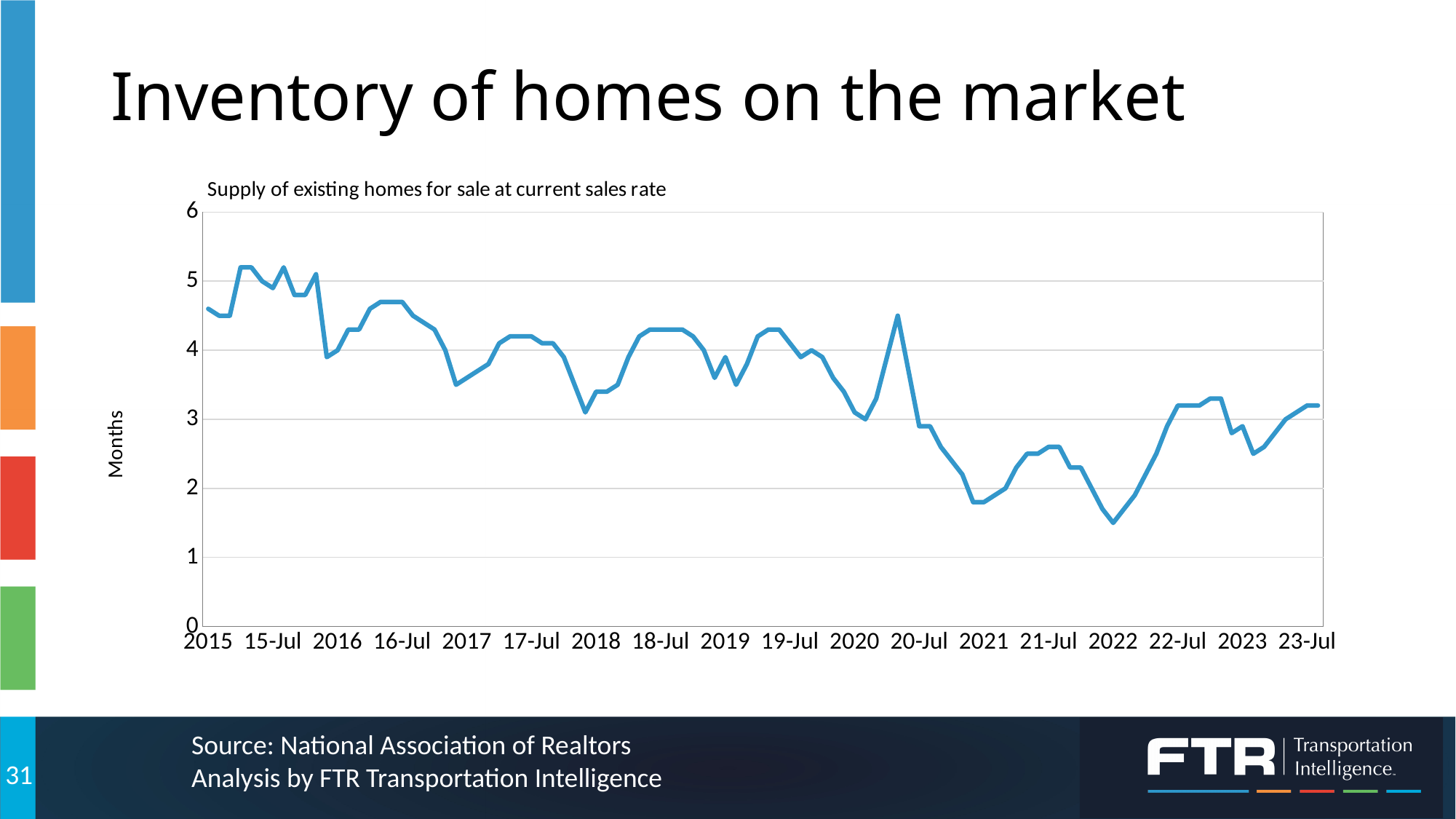
Is the value at 2021 greater or less than 2? less Is the value at 2017 greater or less than 4? less What is the title of the chart? Supply of existing homes for sale at current sales rate Overall, do the values rise or fall from 2015 to 23-Jul? fall What is the label on the vertical axis of the chart? Months Around which year label does the line reach its lowest point? 2022 What kind of chart is shown on the slide? line chart Is the value at 15-Jul greater or less than 4? greater Do the values rise or fall from 2022 to 23-Jul? rise